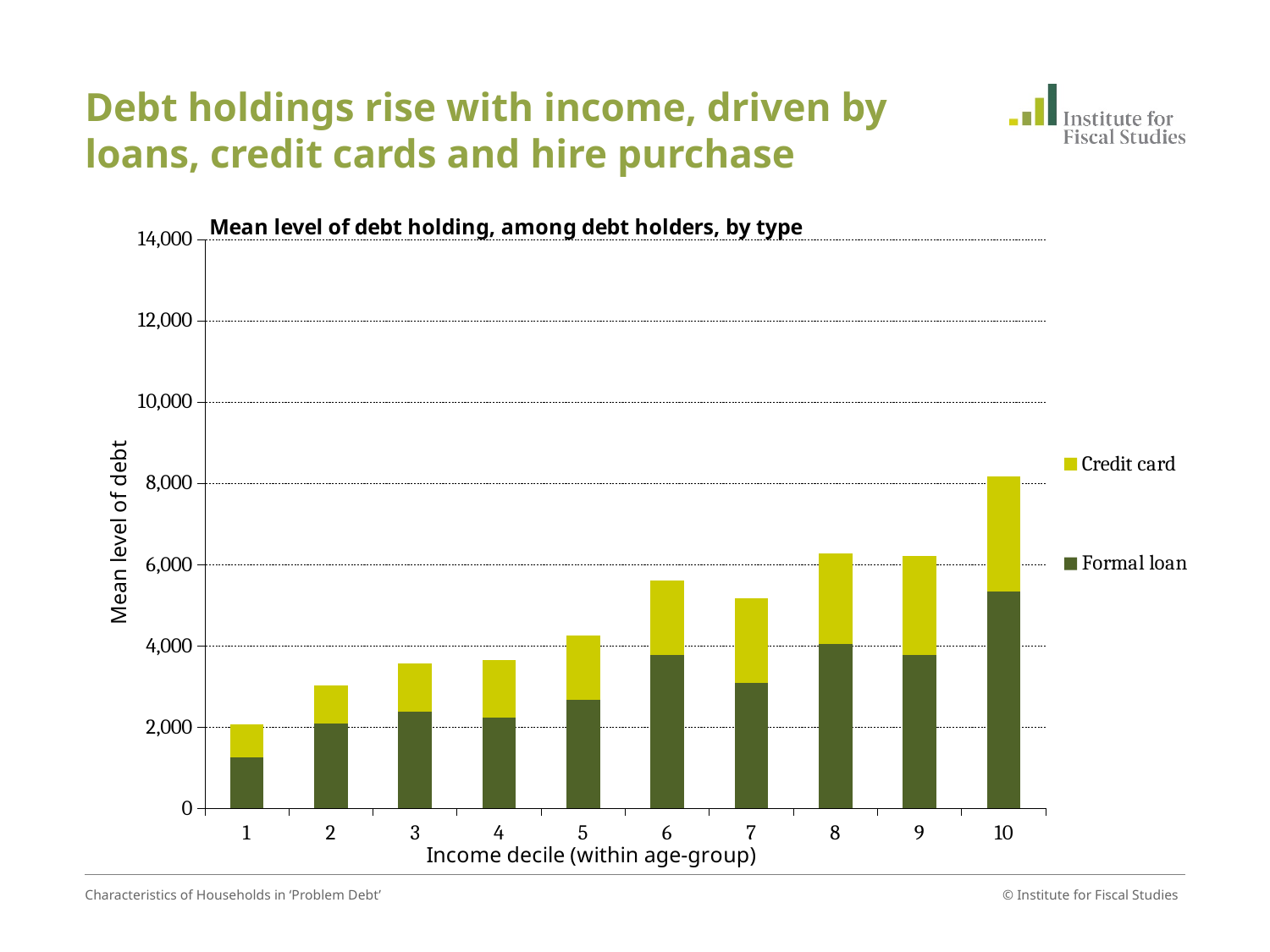
Is the total mean level of debt for income decile 6 greater or less than 4,000? greater Which has a larger total mean level of debt, income decile 6 or income decile 7? 6 What is the title of the chart? Mean level of debt holding, among debt holders, by type How many series does the chart's legend list? 2 Is the Formal loan value for income decile 10 greater or less than 4,000? greater How many income deciles are shown on the x axis of the chart? 10 What kind of chart is shown on the slide? Stacked bar chart Is the total mean level of debt for income decile 1 greater or less than 4,000? less Which income decile has the highest total mean level of debt? 10 Overall, does the total mean level of debt rise or fall as income decile increases? rise Which income decile has the lowest total mean level of debt? 1